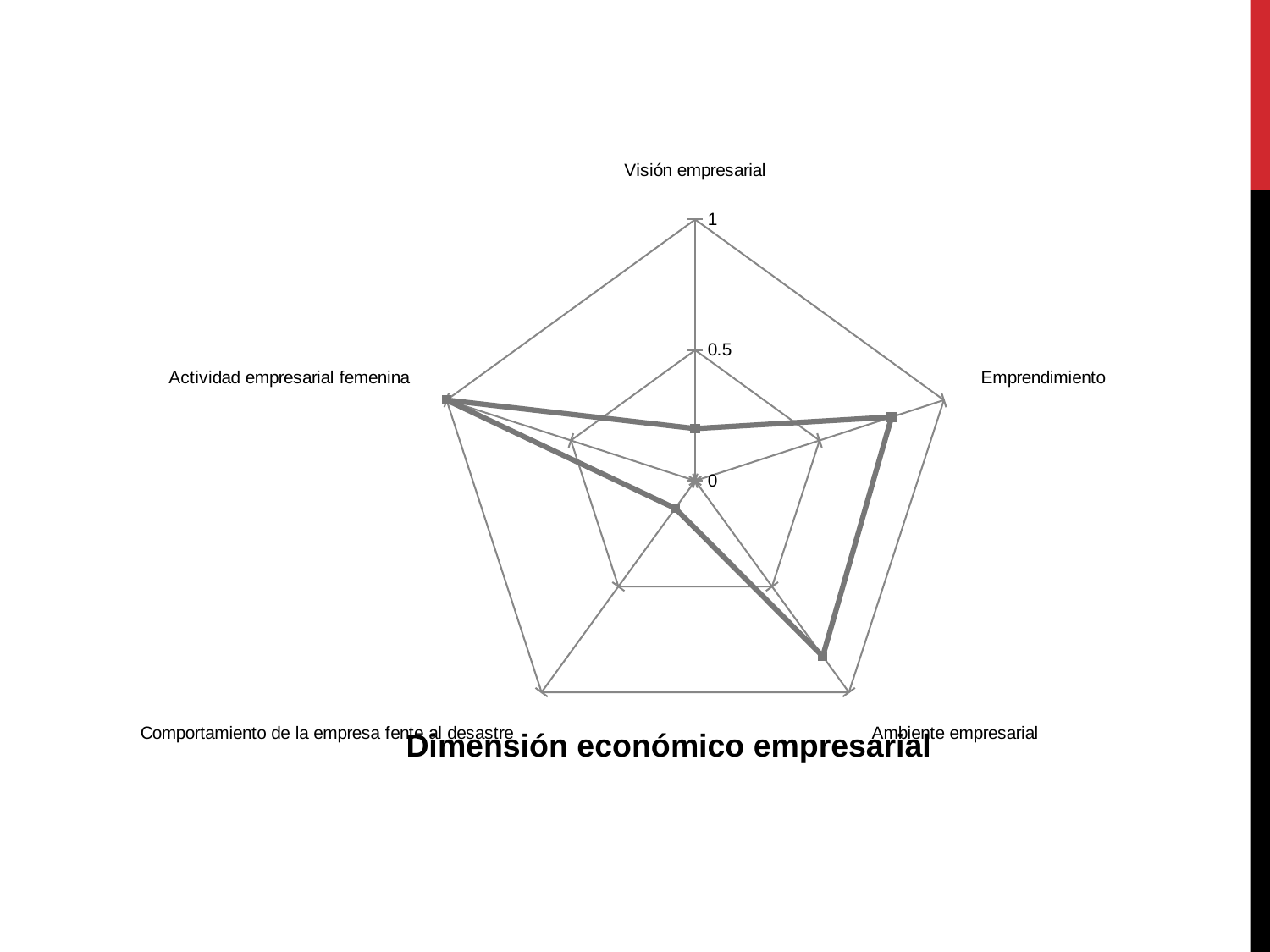
What is the maximum value shown on the chart's axis scale? 1 What is the title of the chart? Dimensión económico empresarial Is the value for Ambiente empresarial greater or less than 0.5? greater Is the value for Visión empresarial greater or less than 0.5? less Which category has the highest value on the chart? Actividad empresarial femenina Is the value for Emprendimiento greater or less than 0.5? greater Which has the larger value, Emprendimiento or Comportamiento de la empresa frente al desastre? Emprendimiento What kind of chart is shown on the slide? Radar chart Which has the larger value, Actividad empresarial femenina or Visión empresarial? Actividad empresarial femenina How many categories (axes) does the radar chart have? 5